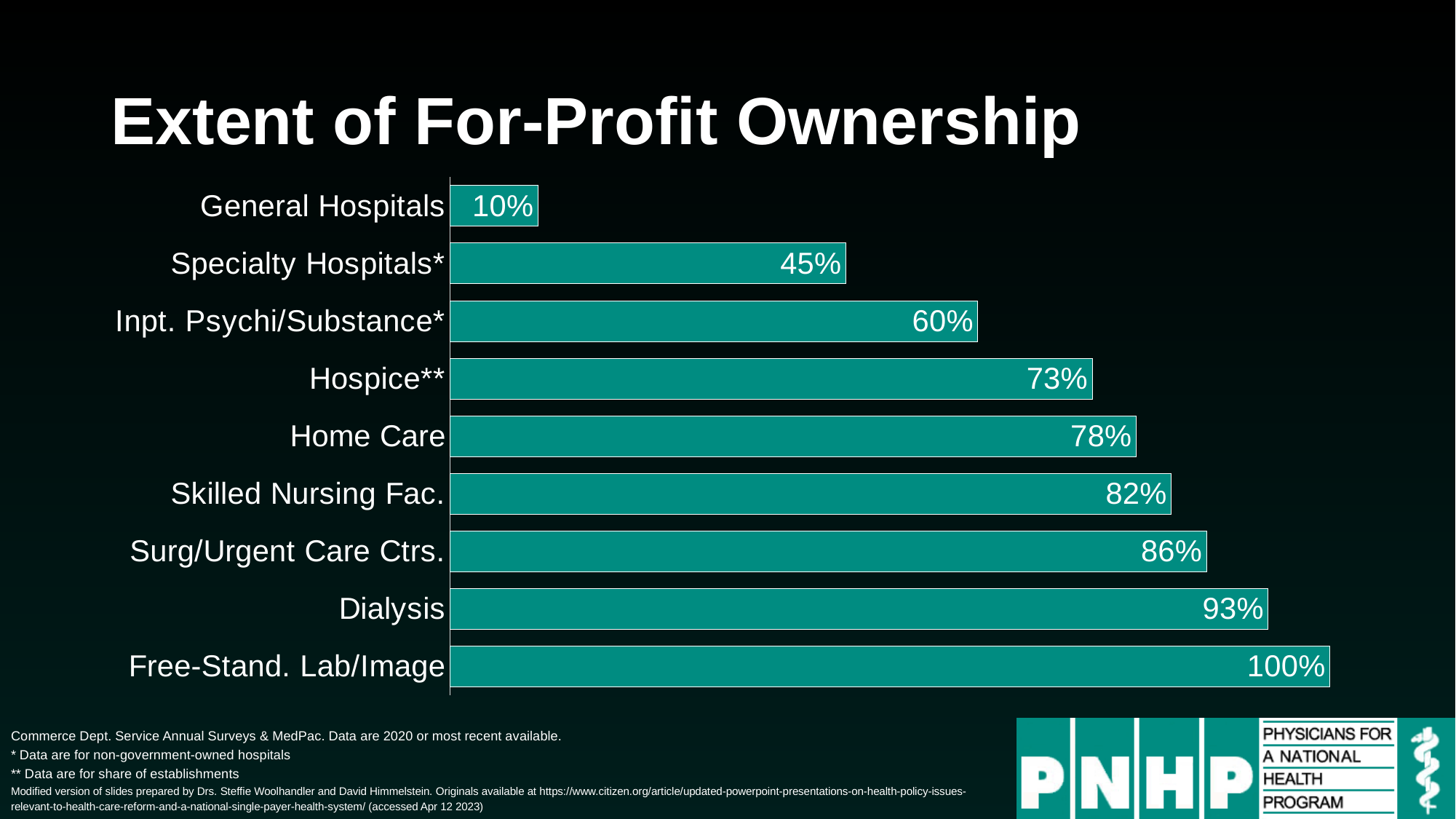
What colour are the bars in the chart? Teal Which category has the highest value? Free-Stand. Lab/Image What is the value for Hospice**? 73% How many categories are shown in the chart? 9 What is the difference between the values for Dialysis and Home Care? 15% What is the value for Skilled Nursing Fac.? 82% Which is larger, the value for Surg/Urgent Care Ctrs. or the value for Hospice**? Surg/Urgent Care Ctrs. What is the difference between the values for Inpt. Psychi/Substance* and General Hospitals? 50% What is the title of the chart? Extent of For-Profit Ownership Which category has the lowest value? General Hospitals What kind of chart is shown on the slide? Bar chart What is the value for Specialty Hospitals*? 45%